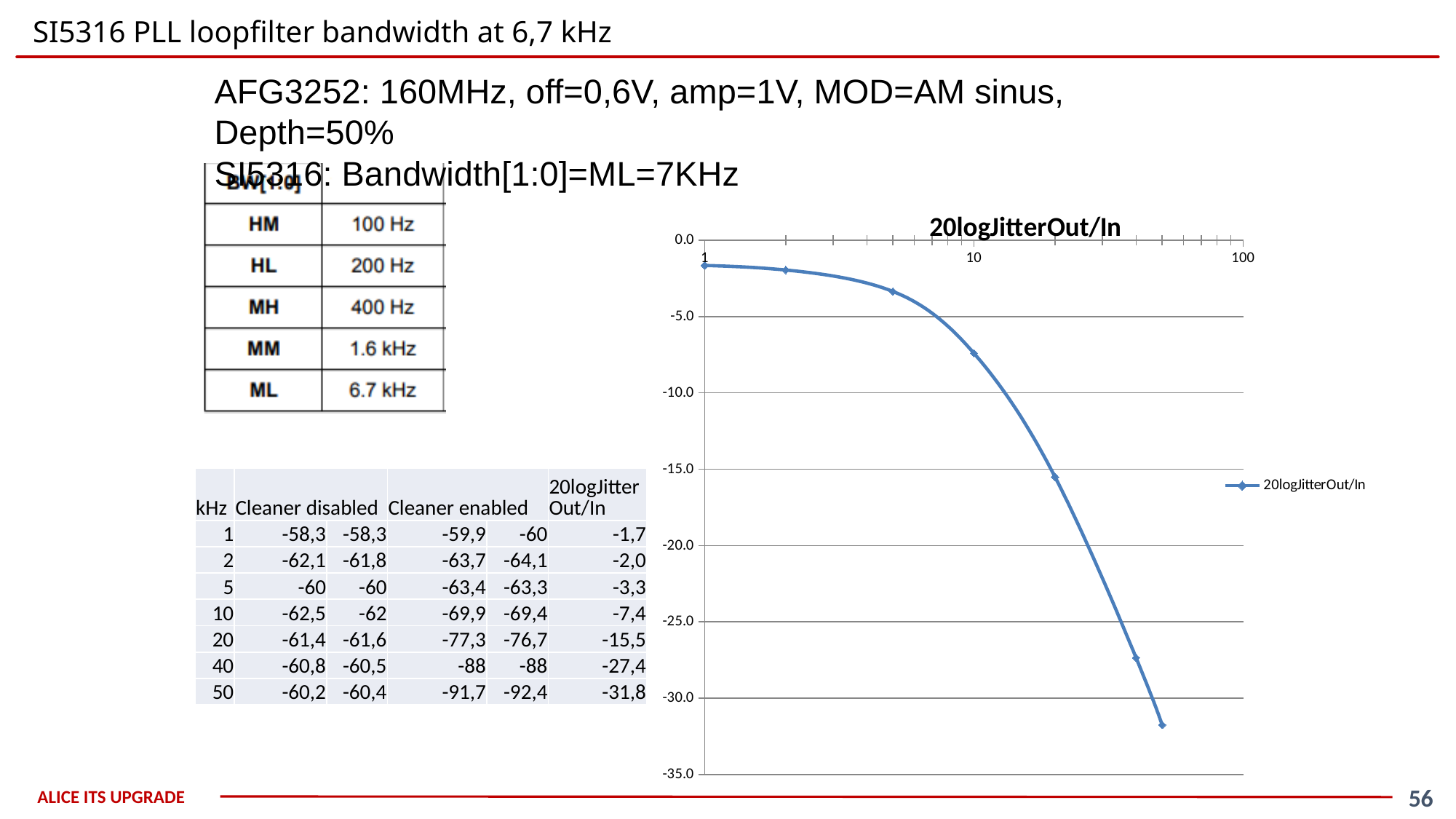
How many series does the chart legend list? 1 Is the value of 20logJitterOut/In at x = 1 greater or less than -5.0? greater Is the value of 20logJitterOut/In at x = 20 greater or less than -10.0? less At which x value does the 20logJitterOut/In line reach its lowest point? 50 What is the title of the chart? 20logJitterOut/In Is the value of 20logJitterOut/In at x = 40 greater or less than -25.0? less What kind of chart is shown on the slide? line chart How many data points are plotted on the 20logJitterOut/In line? 7 Do the values of 20logJitterOut/In rise or fall as the x axis increases? fall Which is larger, the value of 20logJitterOut/In at x = 5 or at x = 20? x = 5